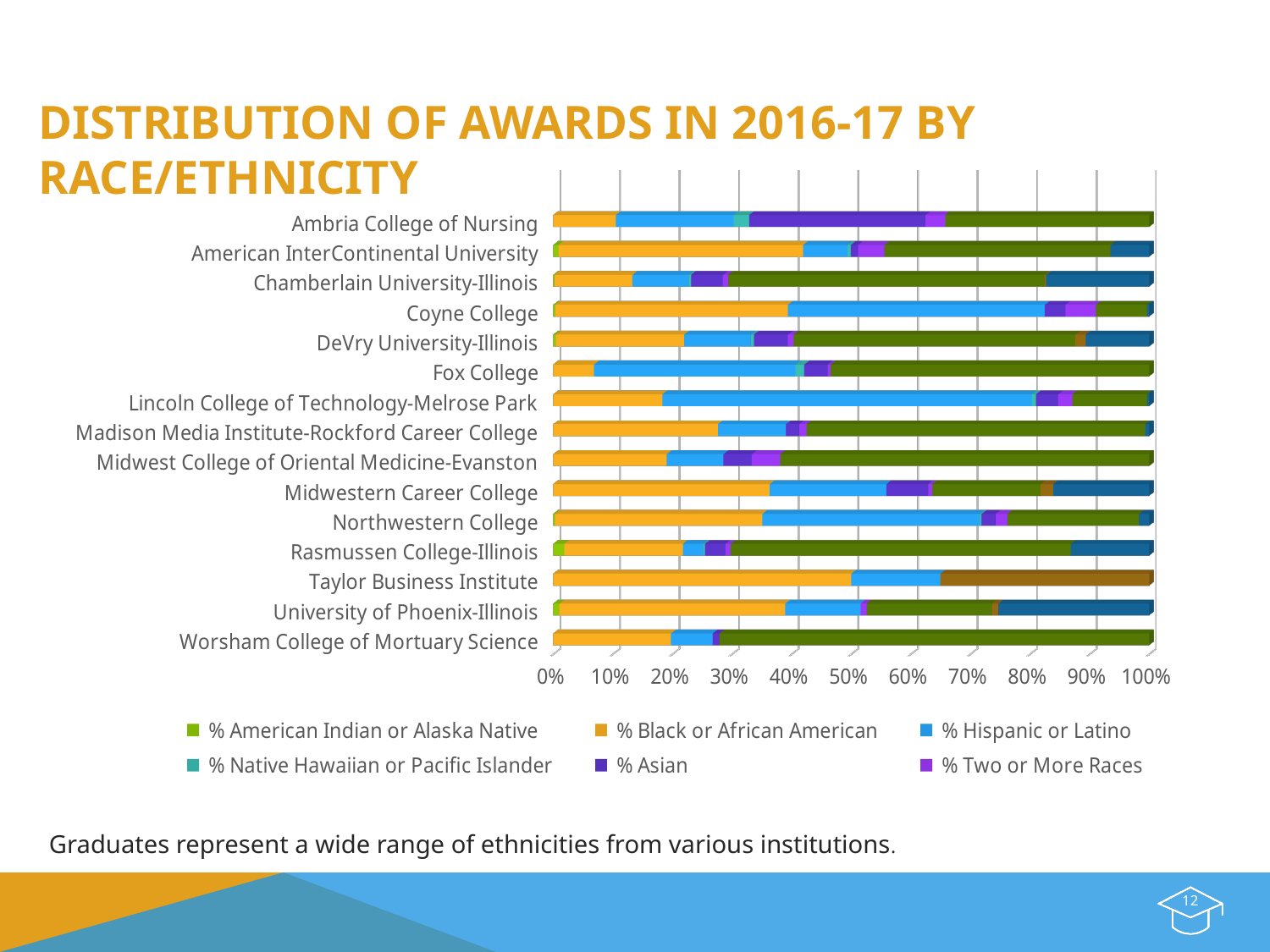
Which is larger: the % Black or African American share for Taylor Business Institute or for Fox College? Taylor Business Institute Which institution has the smallest % Black or African American share? Fox College What kind of chart is shown on the slide? Stacked bar chart Is the % Hispanic or Latino share for Lincoln College of Technology-Melrose Park greater or less than 50%? greater What total does each stacked bar reach on the x axis? 100% Is the % Black or African American share for Fox College greater or less than 10%? less Which institution has the largest % Black or African American share? Taylor Business Institute Is the % Black or African American share for Taylor Business Institute greater or less than 40%? greater How many series does the legend list? 6 What is the title of the chart? Distribution of Awards in 2016-17 by Race/Ethnicity Which institution has the largest % Hispanic or Latino share? Lincoln College of Technology-Melrose Park How many institutions are listed on the chart? 15